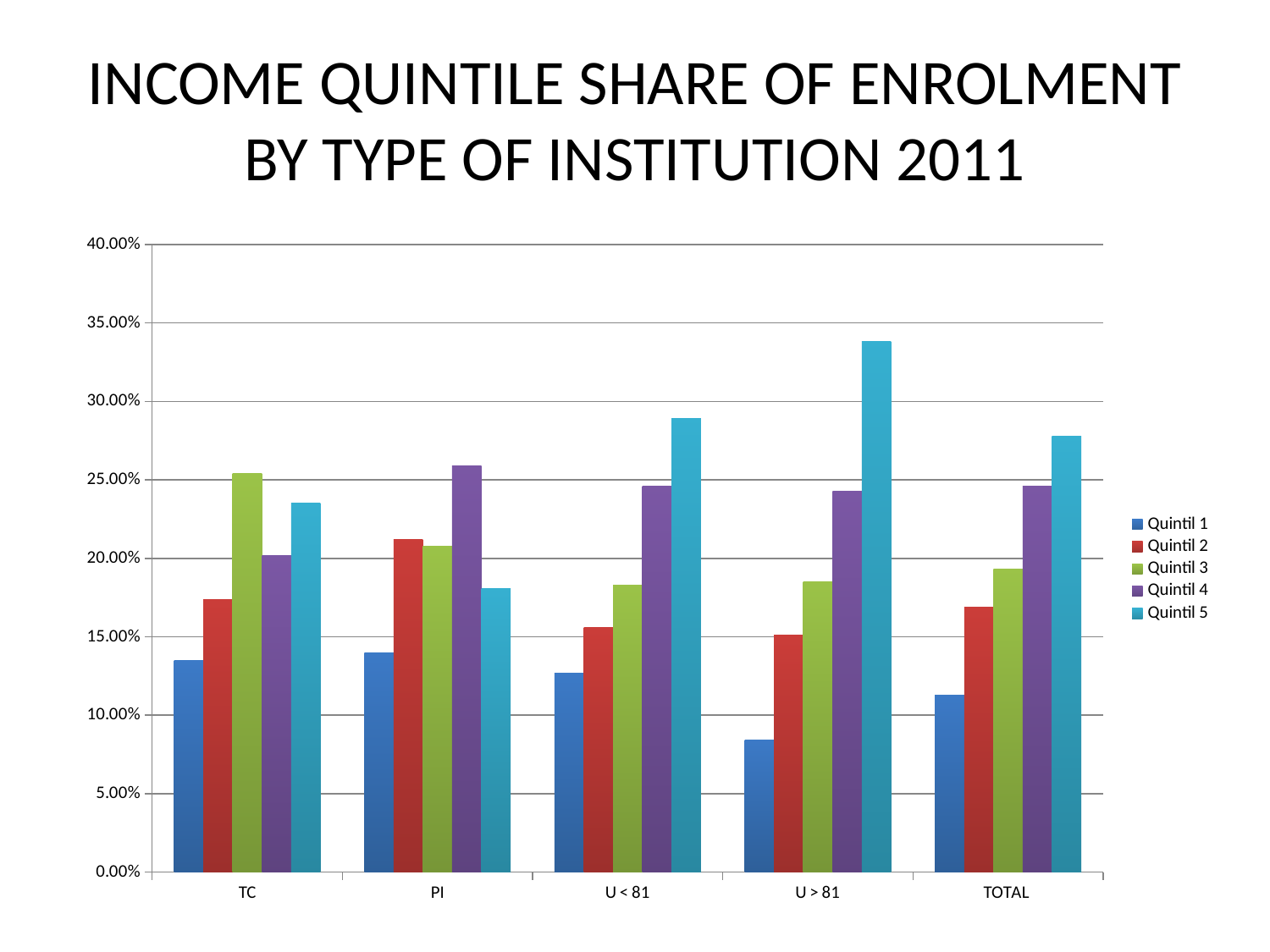
For which institution type is the Quintil 1 bar the lowest? U > 81 What is the title of the slide's chart? INCOME QUINTILE SHARE OF ENROLMENT BY TYPE OF INSTITUTION 2011 Is the Quintil 5 value for U > 81 greater or less than 30.00%? greater For TC, which is larger: the Quintil 3 value or the Quintil 5 value? Quintil 3 Within the TC category, which quintile has the highest bar? Quintil 3 What kind of chart is shown on the slide? bar chart Is the Quintil 5 value for TOTAL greater or less than 25.00%? greater How many institution types (categories) are shown on the x axis? 5 How many series does the legend list? 5 Is the Quintil 1 value for U > 81 greater or less than 10.00%? less For which institution type is the Quintil 5 bar the highest? U > 81 For PI, which is larger: the Quintil 4 value or the Quintil 5 value? Quintil 4